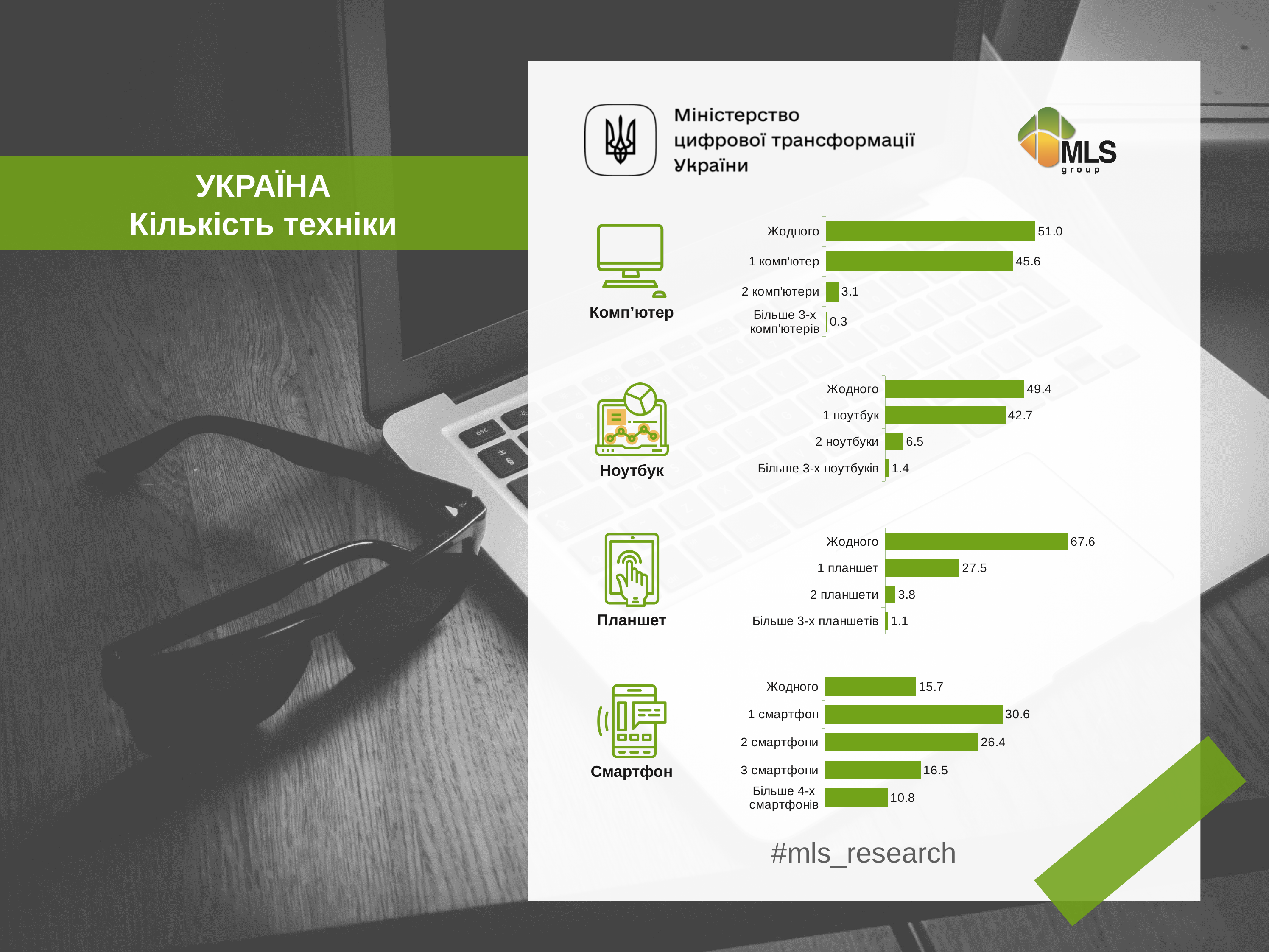
In the Комп’ютер chart, what is the value for 2 комп’ютери? 3.1 In the Смартфон chart, which is larger: Жодного or 3 смартфони? 3 смартфони In the Смартфон chart, which category has the highest value? 1 смартфон In the Планшет chart, which category has the highest value? Жодного In the Комп’ютер chart, what is the value for Жодного? 51.0 In the Ноутбук chart, what is the difference between Жодного and 2 ноутбуки? 42.9 In the Смартфон chart, what is the value for Більше 4-х смартфонів? 10.8 How many categories does the Смартфон chart have? 5 In the Ноутбук chart, what is the value for 1 ноутбук? 42.7 In the Ноутбук chart, which category has the lowest value? Більше 3-х ноутбуків What kind of chart is the Ноутбук chart? Bar chart In the Планшет chart, what is the difference between Жодного and 1 планшет? 40.1